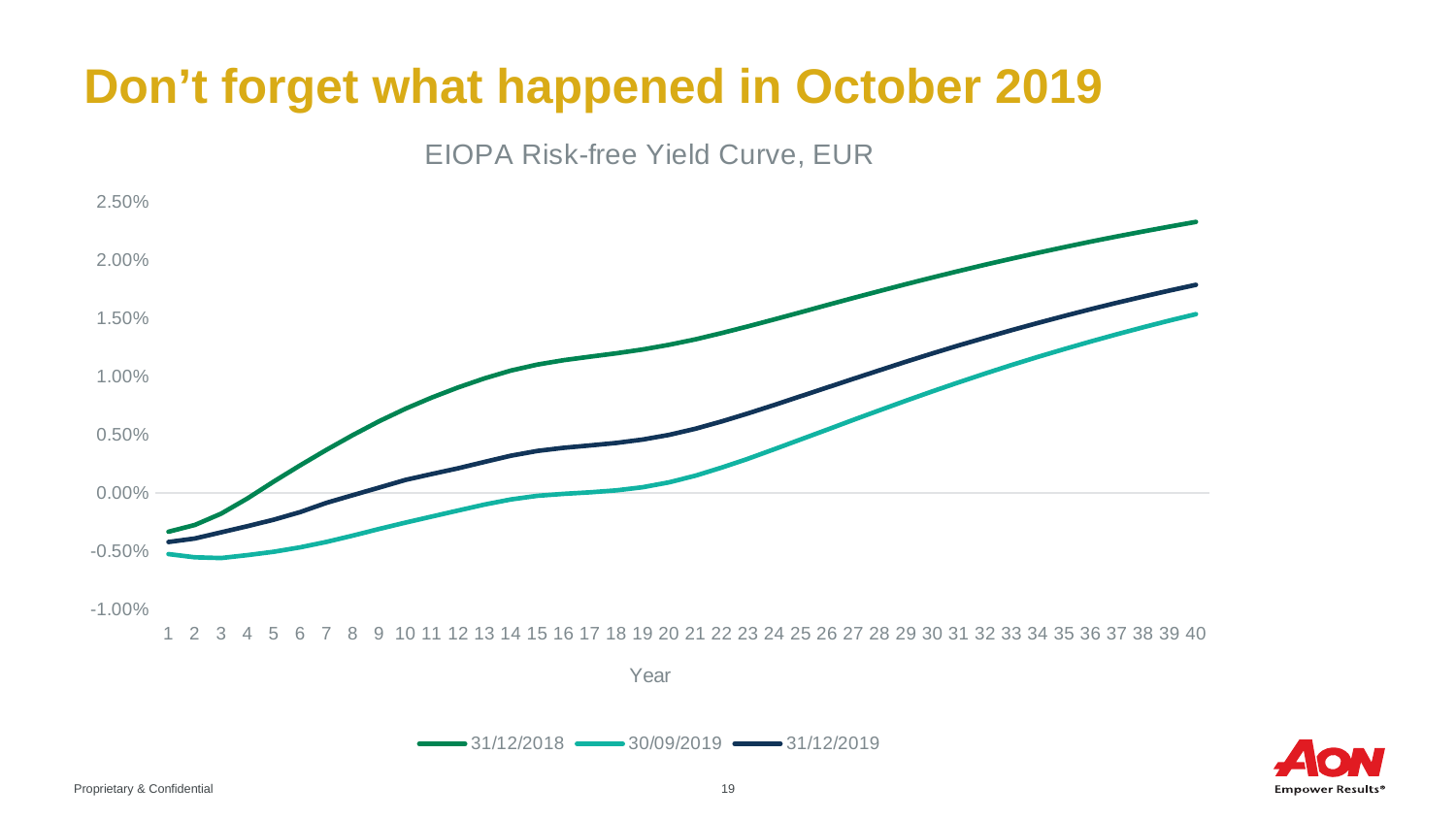
How many years are shown along the x axis? 40 At year 40, which is higher: the 31/12/2019 series or the 30/09/2019 series? 31/12/2019 What is the label of the x axis? Year Which series has the lowest value at year 1? 30/09/2019 Is the value for the 30/09/2019 series at year 10 greater or less than 0.00%? less How many series does the legend list? 3 Do the values of the 31/12/2018 series generally rise or fall as the year increases? rise Which series has the highest value at year 40? 31/12/2018 Is the value for the 31/12/2019 series at year 40 greater or less than 2.00%? less Is the value for the 31/12/2018 series at year 40 greater or less than 2.00%? greater What kind of chart is shown on the slide? Line chart What is the title of the chart? EIOPA Risk-free Yield Curve, EUR